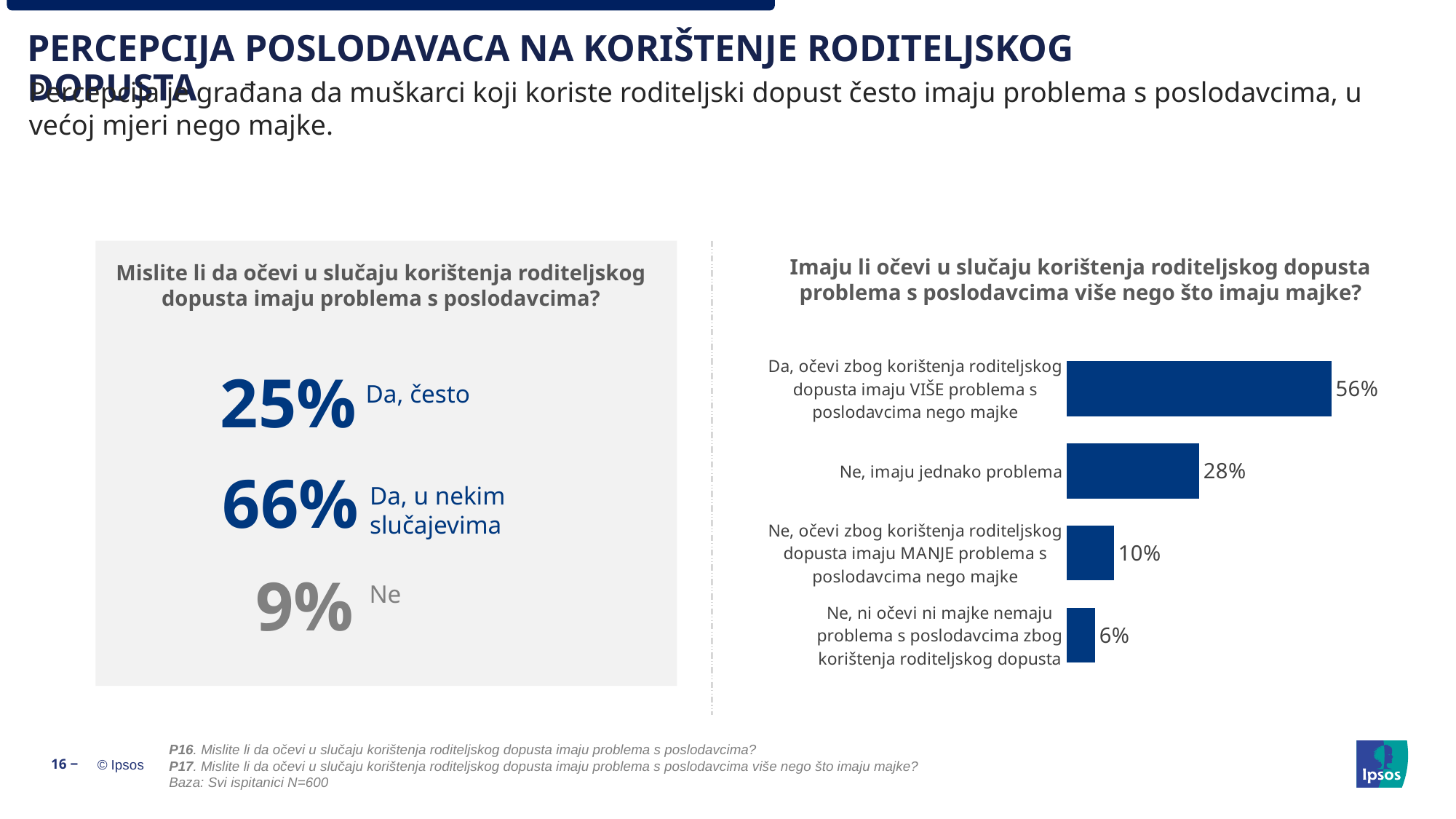
In the bar chart on the right, which category has the highest value? Da, očevi zbog korištenja roditeljskog dopusta imaju VIŠE problema s poslodavcima nego majke What colour are the bars in the bar chart on the right? Dark blue How many categories does the bar chart on the right show? 4 In the bar chart on the right, which category has the lowest value? Ne, ni očevi ni majke nemaju problema s poslodavcima zbog korištenja roditeljskog dopusta In the bar chart on the right, what is the value for "Ne, ni očevi ni majke nemaju problema s poslodavcima zbog korištenja roditeljskog dopusta"? 6% In the bar chart on the right, what is the difference between the value for "Ne, očevi ... imaju MANJE problema" and the value for "Ne, ni očevi ni majke nemaju problema"? 4% What is the title of the bar chart on the right? Imaju li očevi u slučaju korištenja roditeljskog dopusta problema s poslodavcima više nego što imaju majke? In the bar chart on the right, what is the value for "Ne, imaju jednako problema"? 28% In the bar chart on the right, what is the value for "Da, očevi zbog korištenja roditeljskog dopusta imaju VIŠE problema s poslodavcima nego majke"? 56% What kind of chart is shown on the right side of the slide? Bar chart In the bar chart on the right, which is larger: the value for "Ne, imaju jednako problema" or the value for "Ne, očevi ... imaju MANJE problema"? Ne, imaju jednako problema In the bar chart on the right, what is the difference between the value for "Da, očevi ... imaju VIŠE problema" and the value for "Ne, imaju jednako problema"? 28%